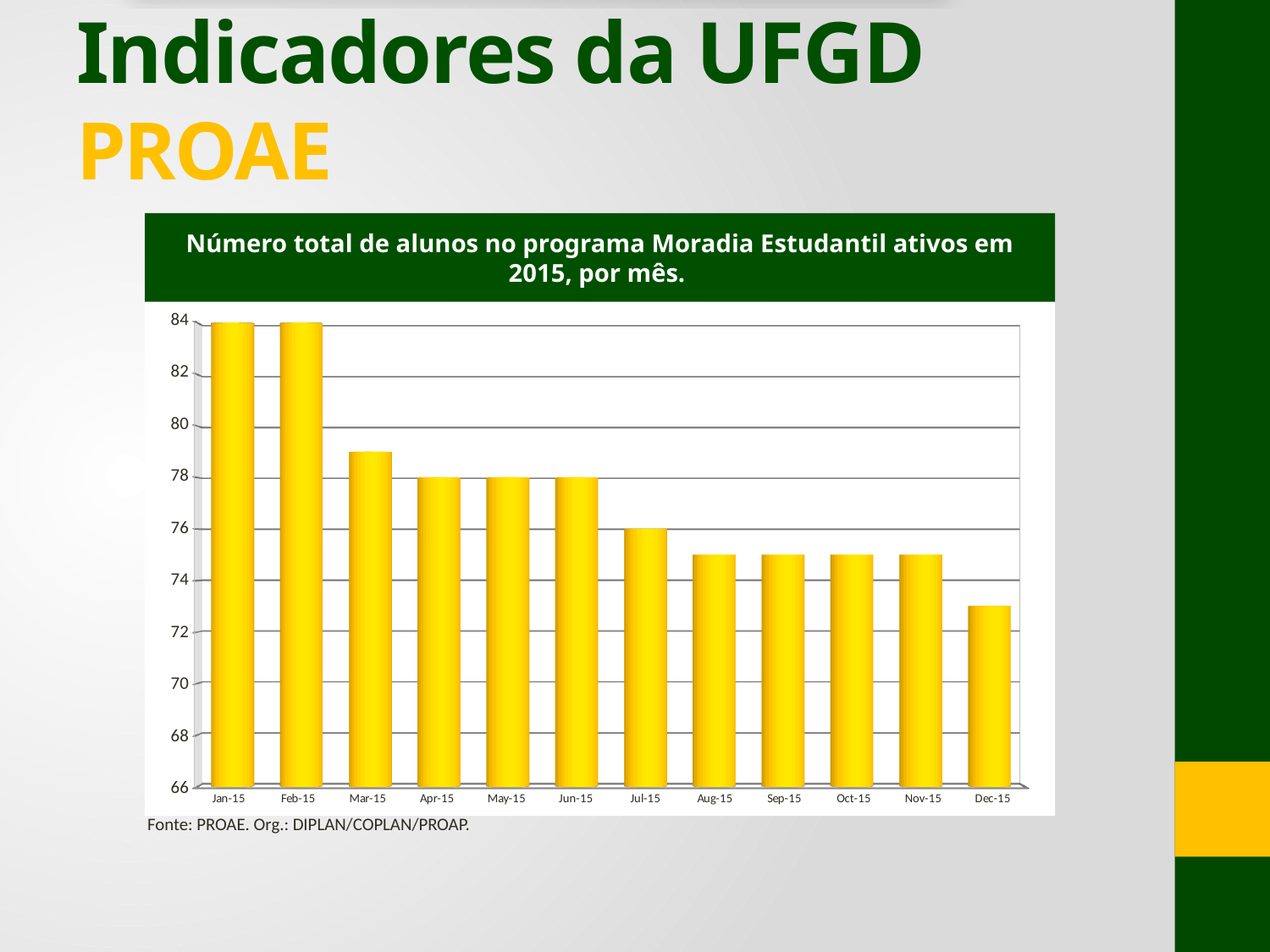
What is the value for Jun-15? 78 Which is larger, the value for Mar-15 or the value for Jul-15? Mar-15 What kind of chart is shown on the slide? bar chart What is the value for Jul-15? 76 Is the value for Sep-15 greater or less than 76? less What is the difference between the value for Jan-15 and the value for Jul-15? 8 Do the values generally rise or fall from Jan-15 to Dec-15? fall Is the value for Dec-15 greater or less than 74? less How many months are plotted on the x axis of the chart? 12 Which month has the lowest value? Dec-15 Is the value for Mar-15 greater or less than 78? greater What is the value for Jan-15? 84